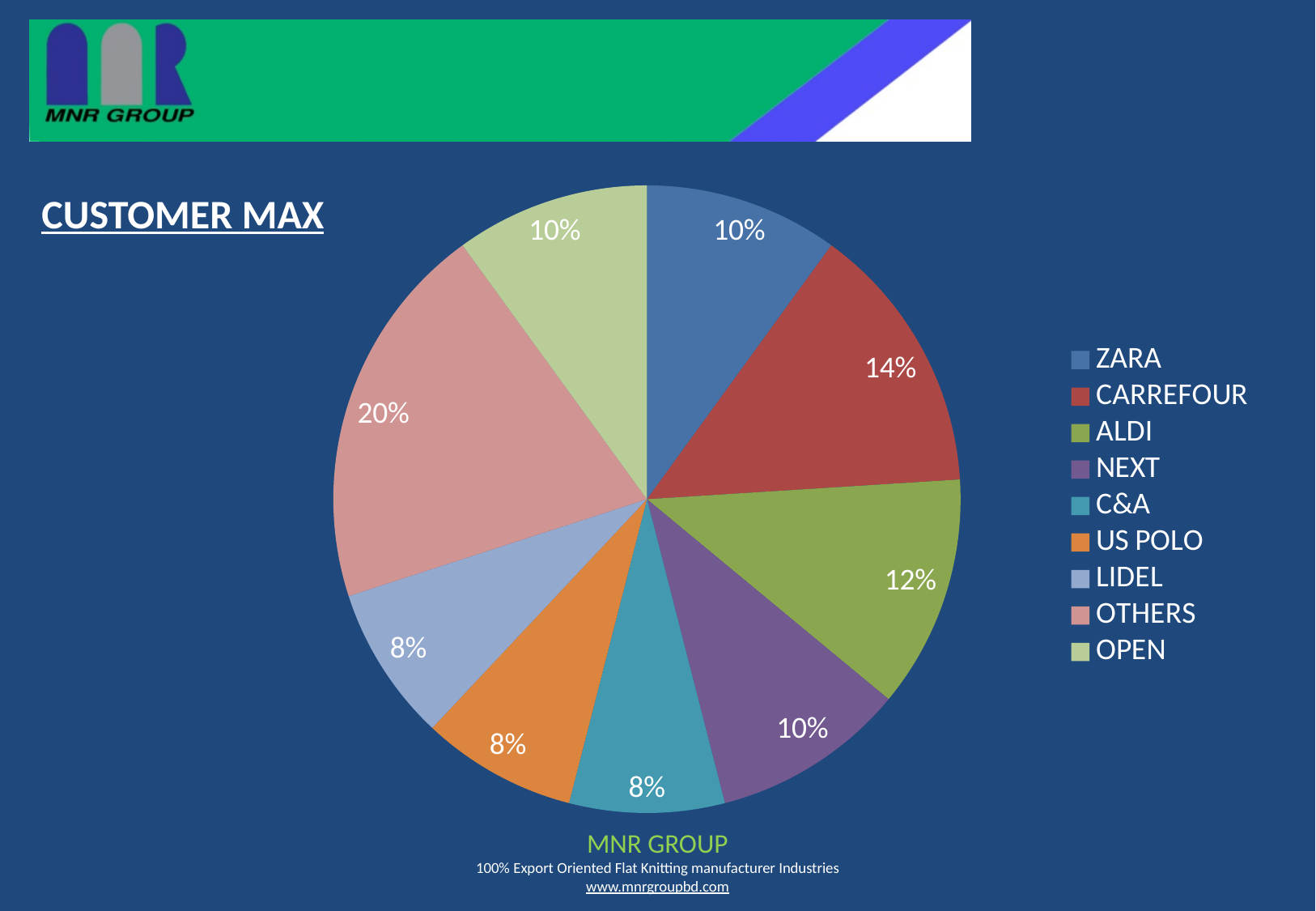
What share of the pie does CARREFOUR hold? 14% What is the difference between the OTHERS slice and the ZARA slice? 10% What is the title shown at the top left of the slide above the chart? CUSTOMER MAX How many categories does the legend list? 9 What kind of chart is shown on the slide? Pie chart What is the difference between the CARREFOUR slice and the C&A slice? 6% Which category has the largest slice of the pie? OTHERS What share of the pie does ALDI hold? 12% How many slices share the value 8%? 3 What share of the pie does OTHERS hold? 20% Which category has the larger slice, CARREFOUR or ALDI? CARREFOUR What share of the pie does LIDEL hold? 8%